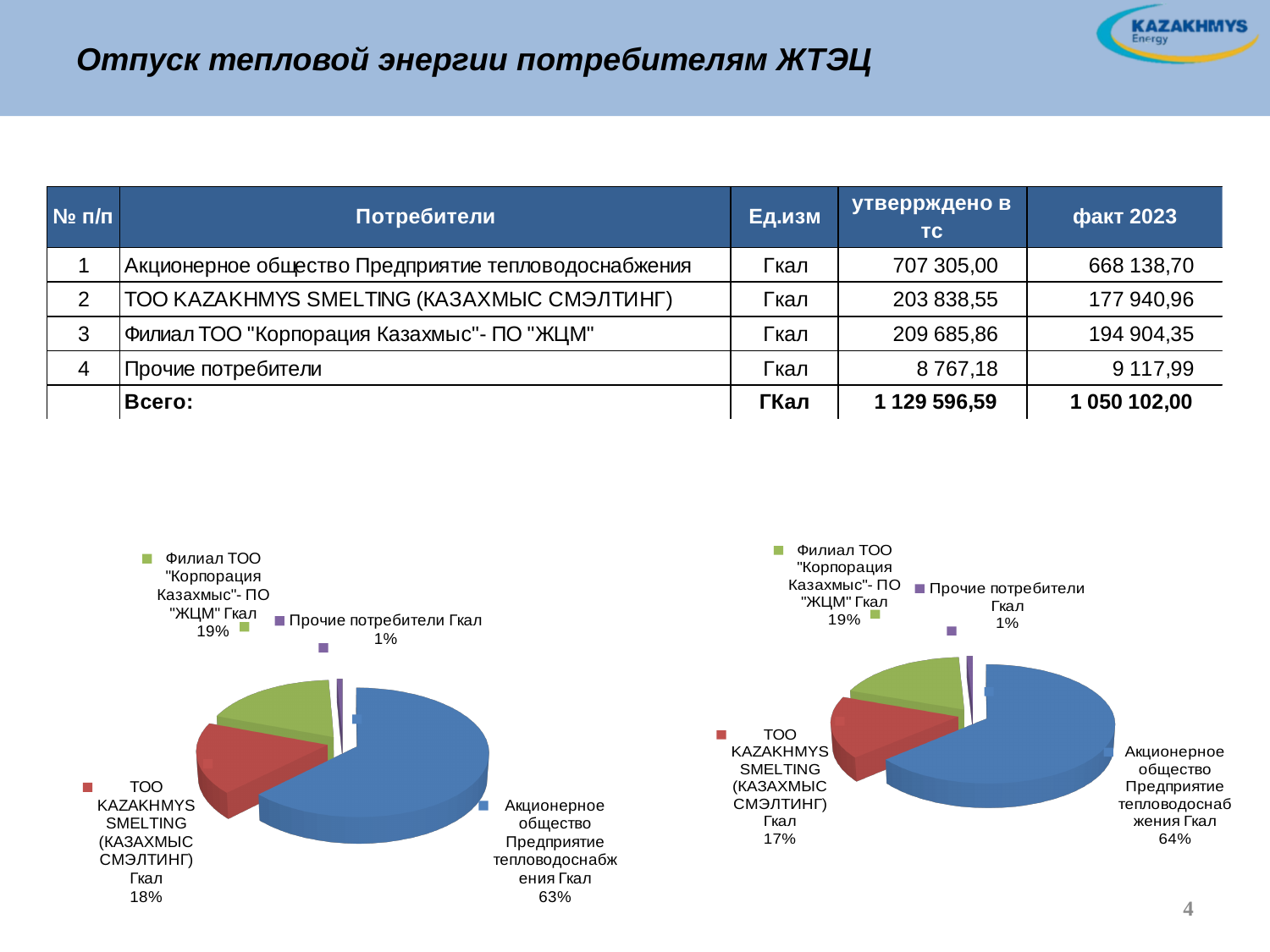
In the left pie chart, what share is shown for ТОО KAZAKHMYS SMELTING (КАЗАХМЫС СМЭЛТИНГ) Гкал? 18% In the left pie chart, which slice is larger: ТОО KAZAKHMYS SMELTING (КАЗАХМЫС СМЭЛТИНГ) Гкал or Прочие потребители Гкал? ТОО KAZAKHMYS SMELTING (КАЗАХМЫС СМЭЛТИНГ) Гкал In the right pie chart, which category has the smallest slice? Прочие потребители Гкал In the right pie chart, what share is shown for ТОО KAZAKHMYS SMELTING (КАЗАХМЫС СМЭЛТИНГ) Гкал? 17% In the right pie chart, what share is shown for Акционерное общество Предприятие тепловодоснабжения Гкал? 64% In the right pie chart, what is the difference in percentage points between the share of Филиал ТОО "Корпорация Казахмыс"- ПО "ЖЦМ" Гкал and the share of ТОО KAZAKHMYS SMELTING (КАЗАХМЫС СМЭЛТИНГ) Гкал? 2 percentage points In the left pie chart, which category has the largest slice? Акционерное общество Предприятие тепловодоснабжения Гкал How many slices does the right pie chart have? 4 What kind of chart is shown on the left side of the slide? pie chart